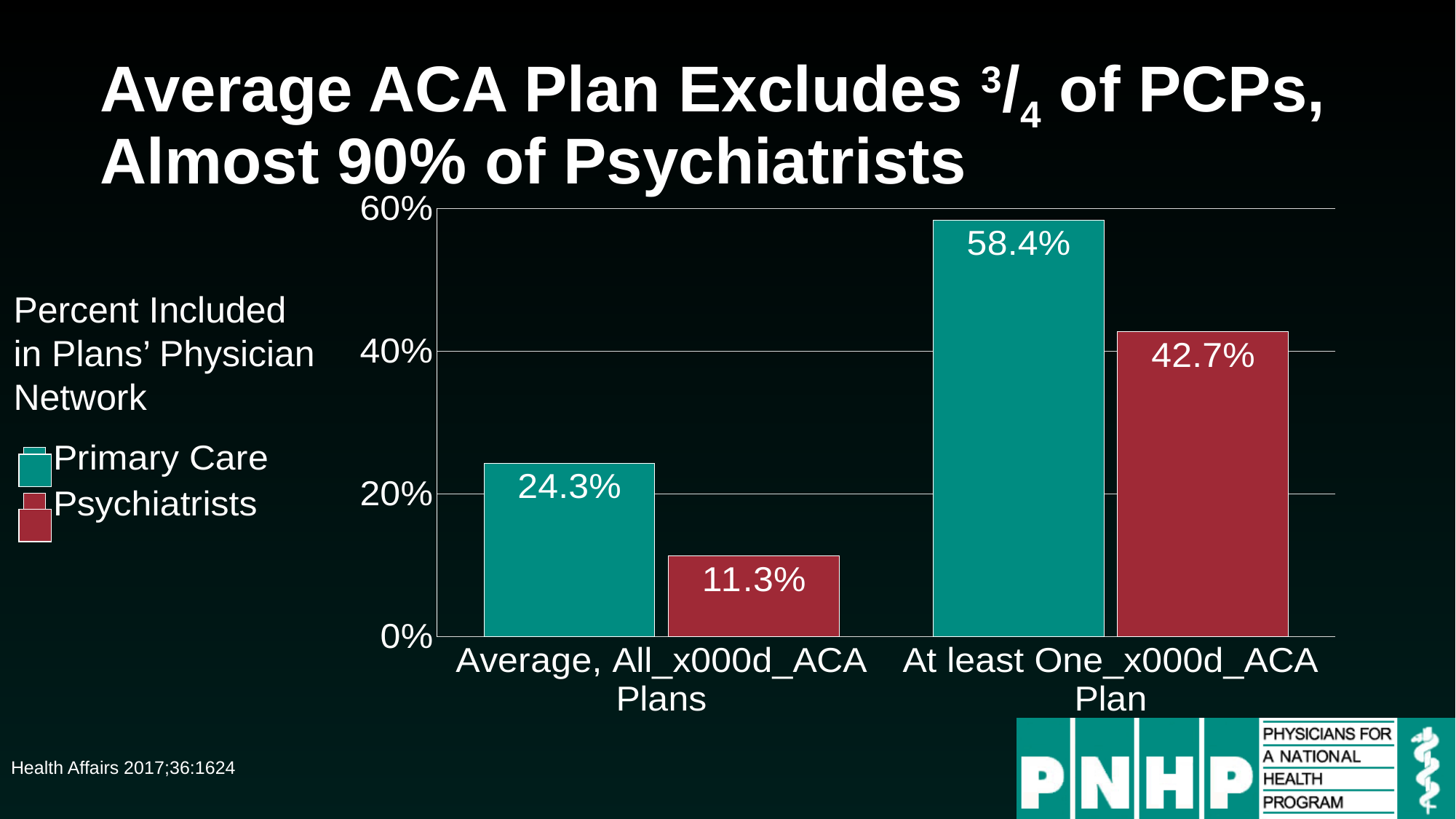
What is the difference between the Primary Care and Psychiatrists values for the average of all ACA plans? 13 percentage points What percentage of primary care physicians are included in the average of all ACA plans? 24.3% For at least one ACA plan, which series has the larger value, Primary Care or Psychiatrists? Primary Care What percentage of psychiatrists are included in at least one ACA plan? 42.7% Which bar shows the lowest value on the chart? Psychiatrists, Average, All ACA Plans (11.3%) Which bar shows the highest value on the chart? Primary Care, At least One ACA Plan (58.4%) What is the difference between the Primary Care and Psychiatrists values for at least one ACA plan? 15.7 percentage points What percentage of psychiatrists are included in the average of all ACA plans? 11.3% How many series does the legend list? 2 What kind of chart is shown on the slide? Bar chart What percentage of primary care physicians are included in at least one ACA plan? 58.4% Which colour represents the Psychiatrists series in the chart? Red